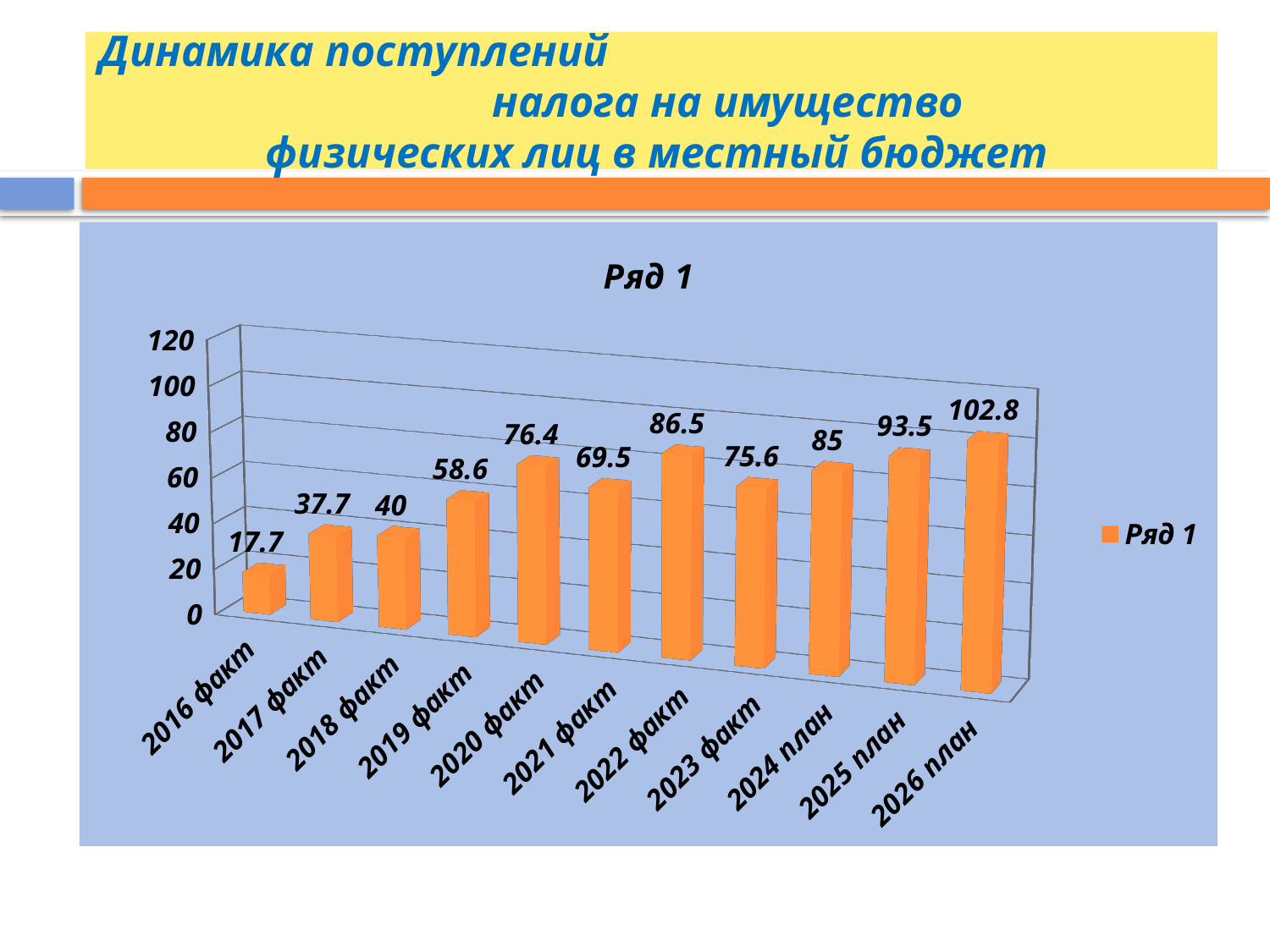
How many series does the legend list? 1 What kind of chart is shown on the slide? bar chart Which category has the lowest value? 2016 факт What is the difference between the values for 2026 план and 2025 план? 9.3 What is the difference between the values for 2018 факт and 2017 факт? 2.3 What is the title of the chart? Ряд 1 What is the value for 2024 план? 85 Which category has the highest value? 2026 план What is the value for 2022 факт? 86.5 Which is larger, the value for 2020 факт or the value for 2021 факт? 2020 факт How many categories are shown on the x axis? 11 What is the value for 2016 факт? 17.7